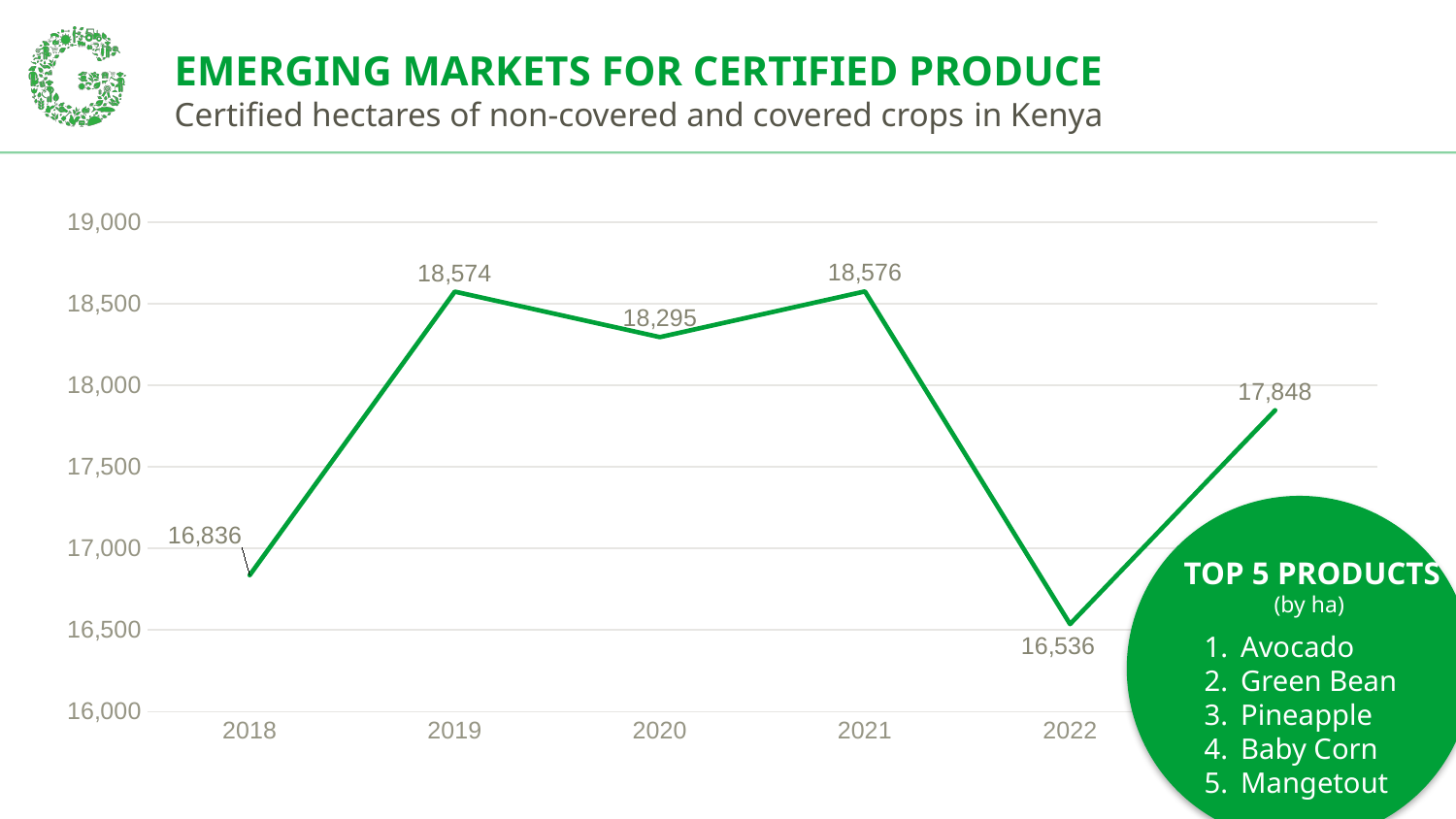
What is the difference between the values for 2019 and 2018? 1,738 What is the value for 2020? 18,295 What kind of chart is shown on the slide? line chart What is the value for 2018? 16,836 Which is larger, the value for 2020 or the value for 2022? 2020 What is the difference between the values for 2021 and 2022? 2,040 What is the value for 2021? 18,576 Is the value for 2018 greater or less than 17,000? less What is the value for 2022? 16,536 Does the value rise or fall from 2021 to 2022? fall Which year has the lowest value? 2022 What is the value for 2019? 18,574